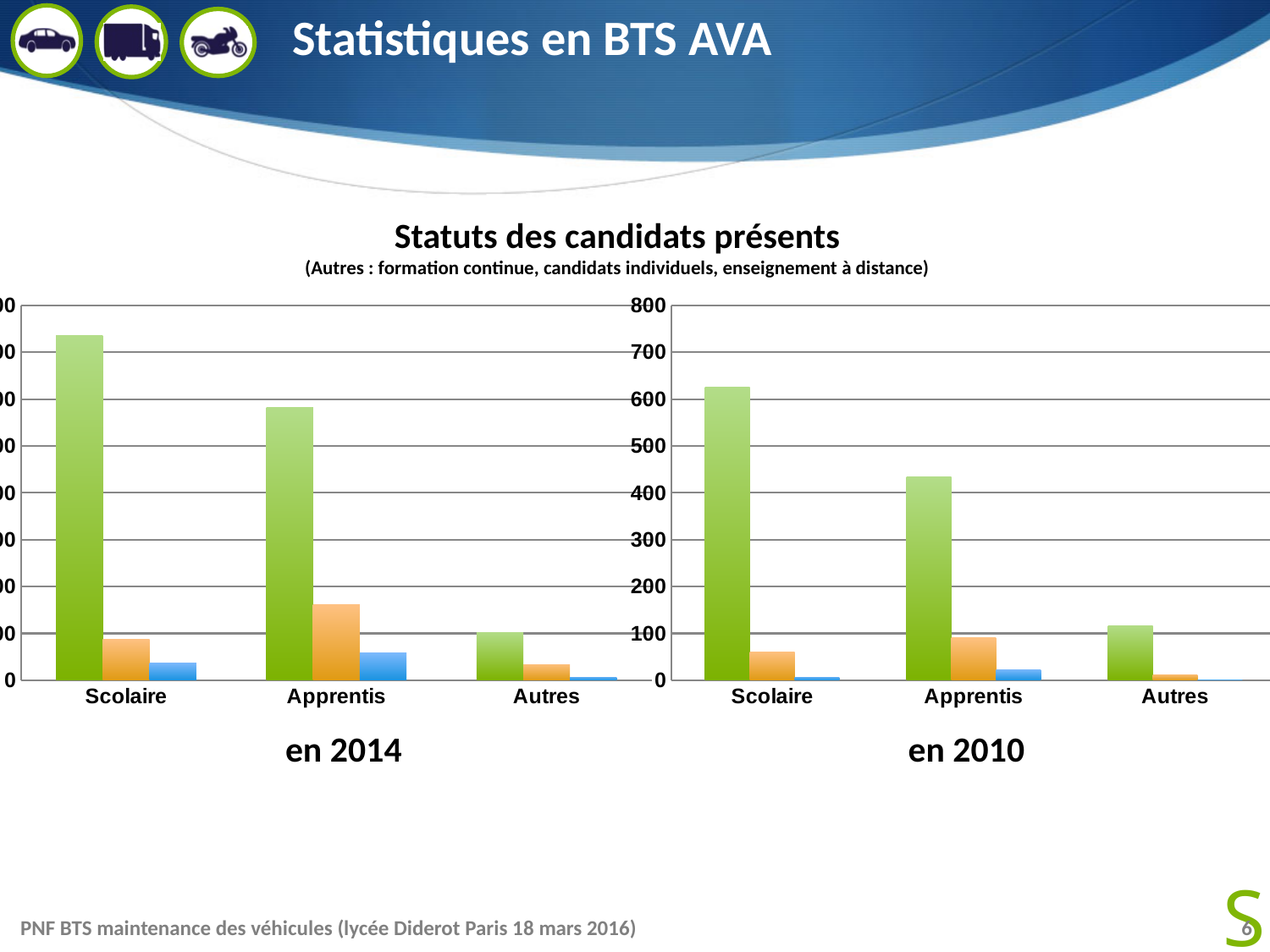
How many categories are shown on the x axis of the 'en 2010' chart? 3 Which year does the chart on the right represent? 2010 In the 'en 2014' chart, which is larger: the orange bar for Scolaire or the orange bar for Apprentis? Apprentis In the 'en 2010' chart, is the green bar for Apprentis greater or less than 400? greater In the 'en 2010' chart, is the green bar for Autres greater or less than 200? less In the 'en 2014' chart, which category has the shortest green bar? Autres In the 'en 2014' chart, do the green bars rise or fall from Scolaire to Autres? fall In the 'en 2010' chart, is the green bar for Scolaire greater or less than 600? greater In the 'en 2010' chart, which category has the tallest green bar? Scolaire What is the main title shown above the two charts? Statuts des candidats présents What kind of chart is the 'en 2014' chart on the left? bar chart